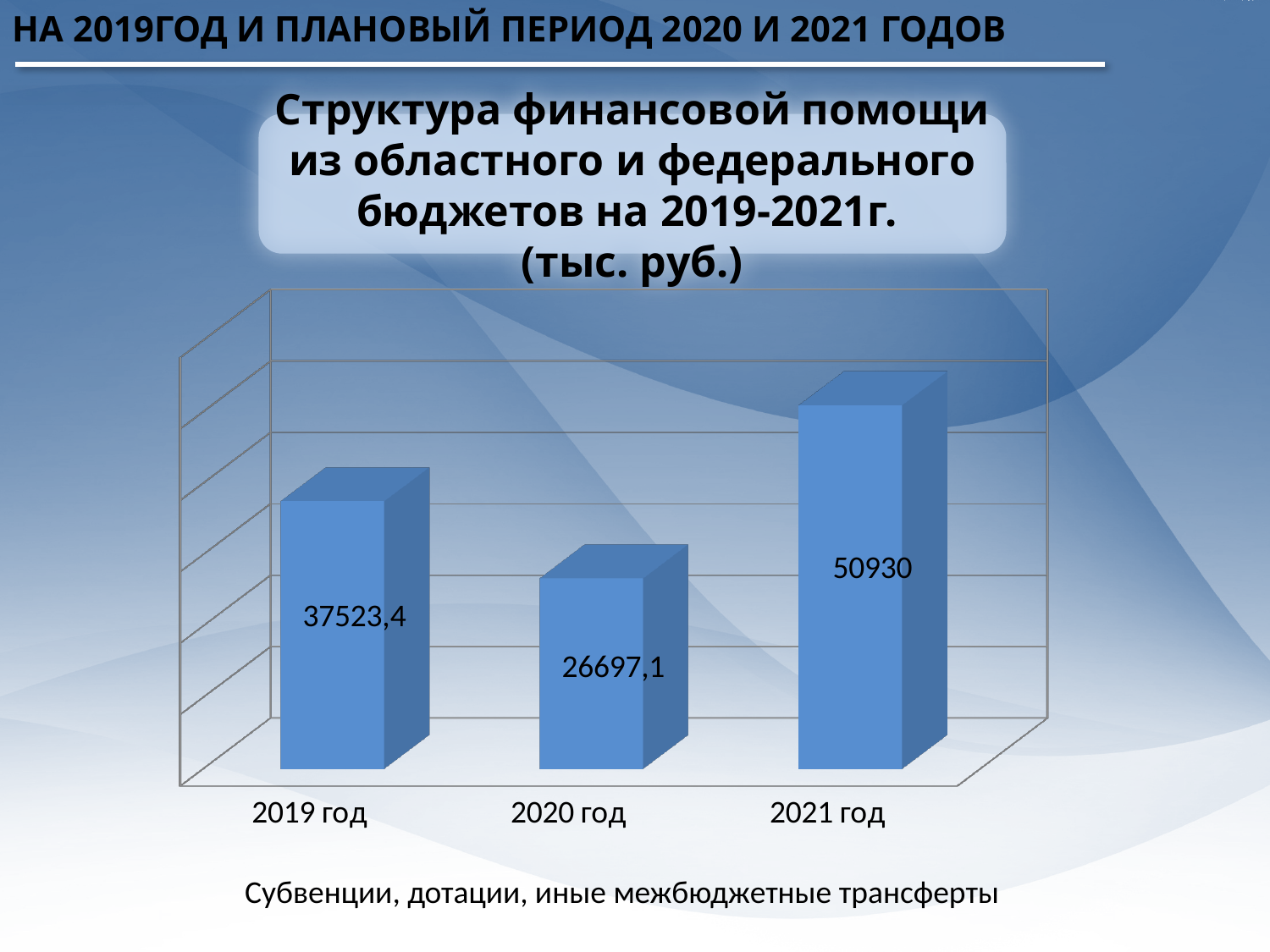
What is the value for 2019 год? 37523,4 In what units are the values in the chart given, according to the title? тыс. руб. What kind of chart is shown on the slide? Bar chart How many bars are shown in the chart? 3 Which is larger, the value for 2019 год or the value for 2020 год? 2019 год Does the value rise or fall from 2020 год to 2021 год? Rises What is the difference between the values for 2019 год and 2020 год? 10826,3 Which year has the lowest value? 2020 год What is the value for 2020 год? 26697,1 What is the difference between the values for 2021 год and 2019 год? 13406,6 Which year has the highest value? 2021 год What is the value for 2021 год? 50930